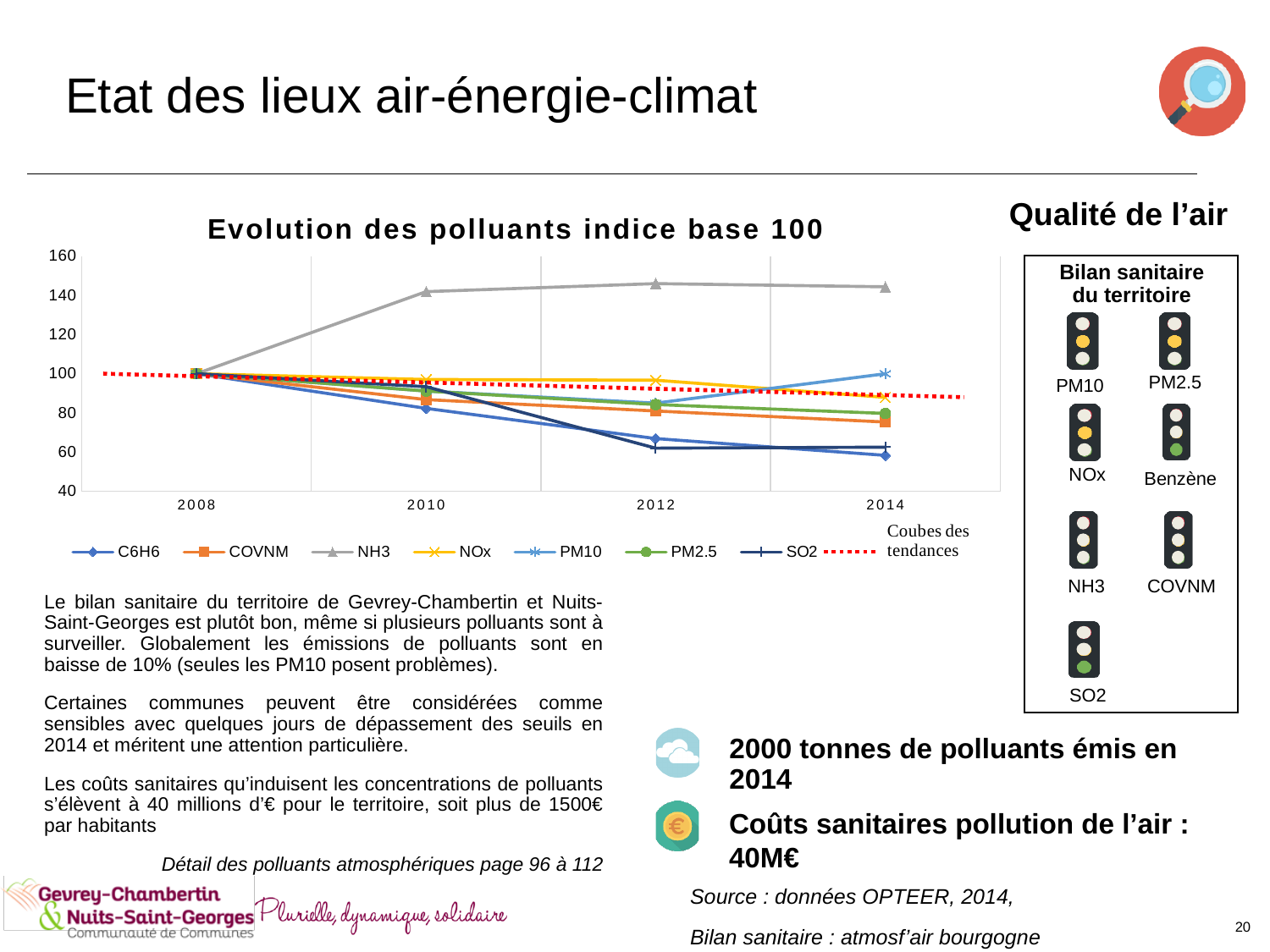
In the 'Evolution des polluants indice base 100' chart, which pollutant has the highest value in 2014? NH3 In the 'Evolution des polluants indice base 100' chart, does the NH3 line rise or fall between 2008 and 2010? rise In the 'Evolution des polluants indice base 100' chart, is the value for COVNM in 2014 greater or less than 80? less What kind of chart is 'Evolution des polluants indice base 100'? line chart In the 'Evolution des polluants indice base 100' chart, which is larger in 2012, NH3 or SO2? NH3 In the 'Evolution des polluants indice base 100' chart, which pollutant has the lowest value in 2014? C6H6 How many entries does the legend of the 'Evolution des polluants indice base 100' chart list? 8 In the 'Evolution des polluants indice base 100' chart, is the value for NH3 in 2012 greater or less than 140? greater How many years are shown on the x axis of the 'Evolution des polluants indice base 100' chart? 4 In the 'Evolution des polluants indice base 100' chart, what is the value of NH3 in 2008? 100 What is the title of the line chart on the slide? Evolution des polluants indice base 100